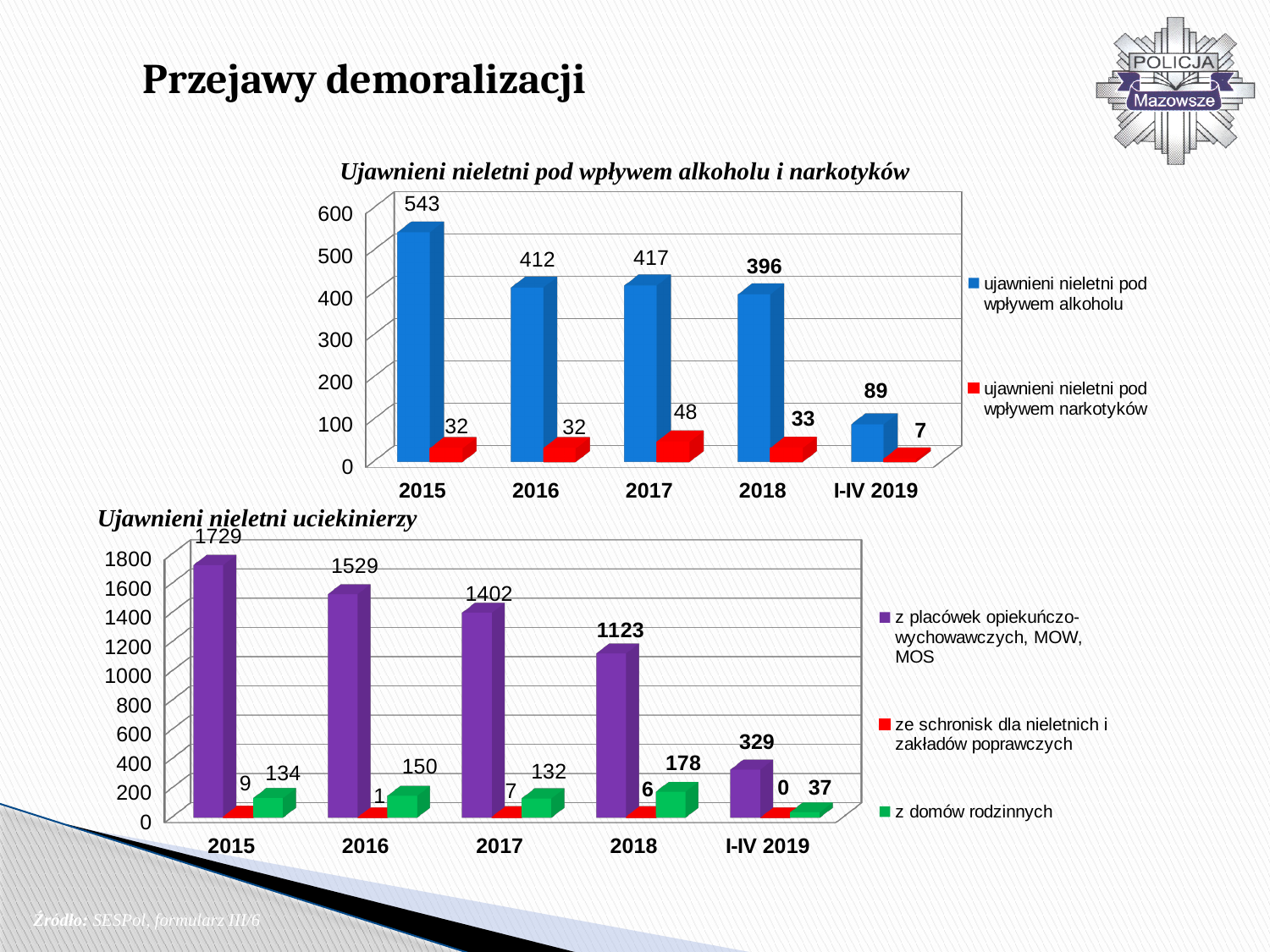
In the chart 'Ujawnieni nieletni pod wpływem alkoholu i narkotyków', what is the value for 'ujawnieni nieletni pod wpływem alkoholu' in 2015? 543 In the chart 'Ujawnieni nieletni uciekinierzy', what is the value for 'z placówek opiekuńczo-wychowawczych, MOW, MOS' in 2018? 1123 In the chart 'Ujawnieni nieletni uciekinierzy', which year has the lowest value for 'ze schronisk dla nieletnich i zakładów poprawczych'? I-IV 2019 In the chart 'Ujawnieni nieletni pod wpływem alkoholu i narkotyków', which year has the highest value for 'ujawnieni nieletni pod wpływem alkoholu'? 2015 In the chart 'Ujawnieni nieletni pod wpływem alkoholu i narkotyków', how many series does the legend list? 2 What kind of chart is 'Ujawnieni nieletni uciekinierzy'? bar chart In the chart 'Ujawnieni nieletni uciekinierzy', does the value for 'z placówek opiekuńczo-wychowawczych, MOW, MOS' rise or fall from 2015 to I-IV 2019? fall In the chart 'Ujawnieni nieletni pod wpływem alkoholu i narkotyków', is the alcohol value for 2017 larger or smaller than the value for 2016? larger In the chart 'Ujawnieni nieletni pod wpływem alkoholu i narkotyków', what is the difference between the alcohol values for 2015 and 2016? 131 In the chart 'Ujawnieni nieletni uciekinierzy', how many categories are shown on the x axis? 5 In the chart 'Ujawnieni nieletni uciekinierzy', what is the value for 'z domów rodzinnych' in 2016? 150 In the chart 'Ujawnieni nieletni pod wpływem alkoholu i narkotyków', what is the value for 'ujawnieni nieletni pod wpływem narkotyków' in 2017? 48